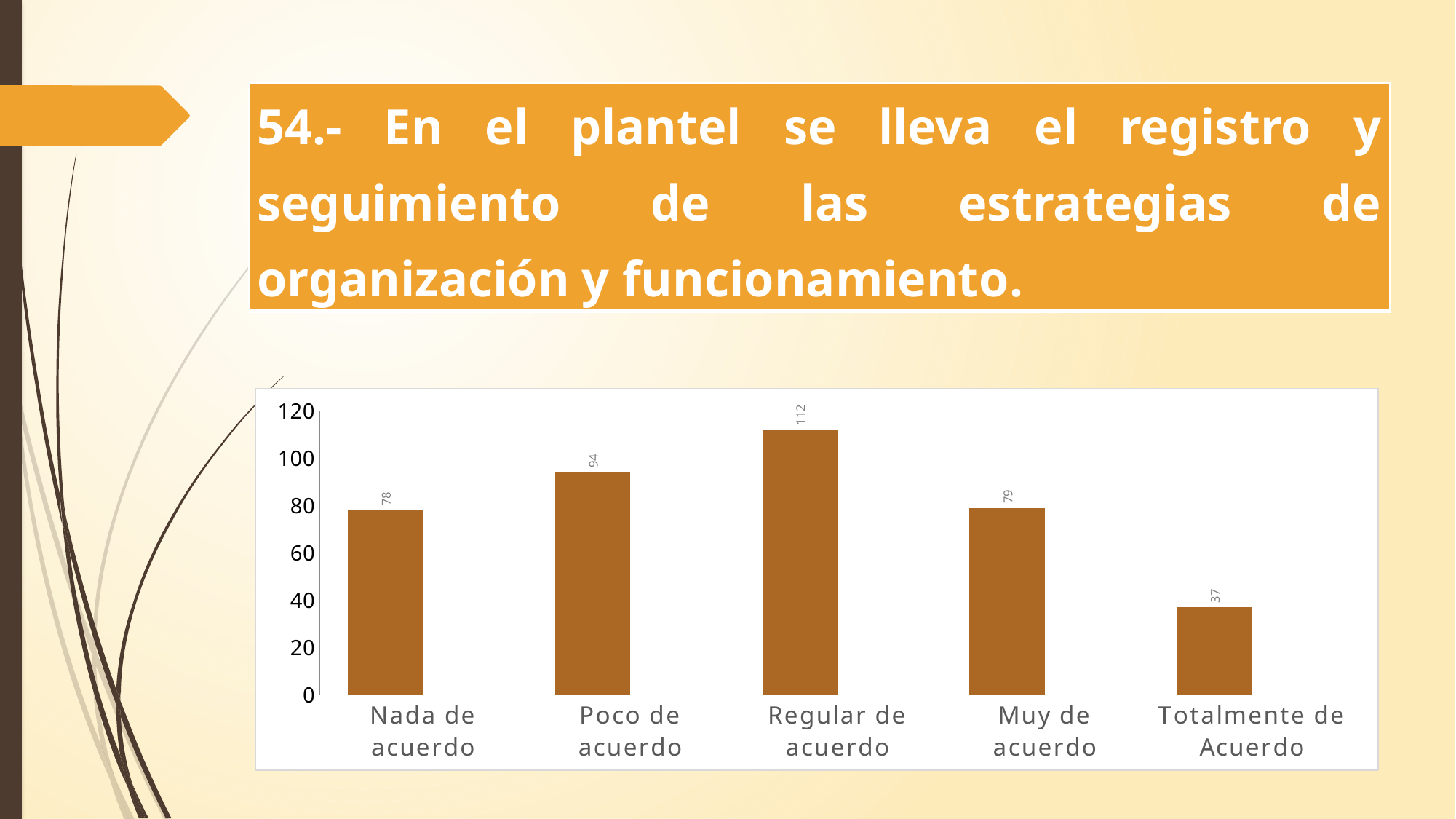
What is the total of the values for Nada de acuerdo and Muy de acuerdo? 157 Is the value for Nada de acuerdo greater or less than 100? less How many categories are shown on the x axis? 5 Which category has the lowest value? Totalmente de Acuerdo Which is larger, the value for Poco de acuerdo or the value for Muy de acuerdo? Poco de acuerdo What is the value for Poco de acuerdo? 94 What is the difference between the values for Regular de acuerdo and Poco de acuerdo? 18 What is the difference between the values for Muy de acuerdo and Totalmente de Acuerdo? 42 What is the value for Totalmente de Acuerdo? 37 What kind of chart is shown on the slide? bar chart Which category has the highest value? Regular de acuerdo What is the value for Regular de acuerdo? 112